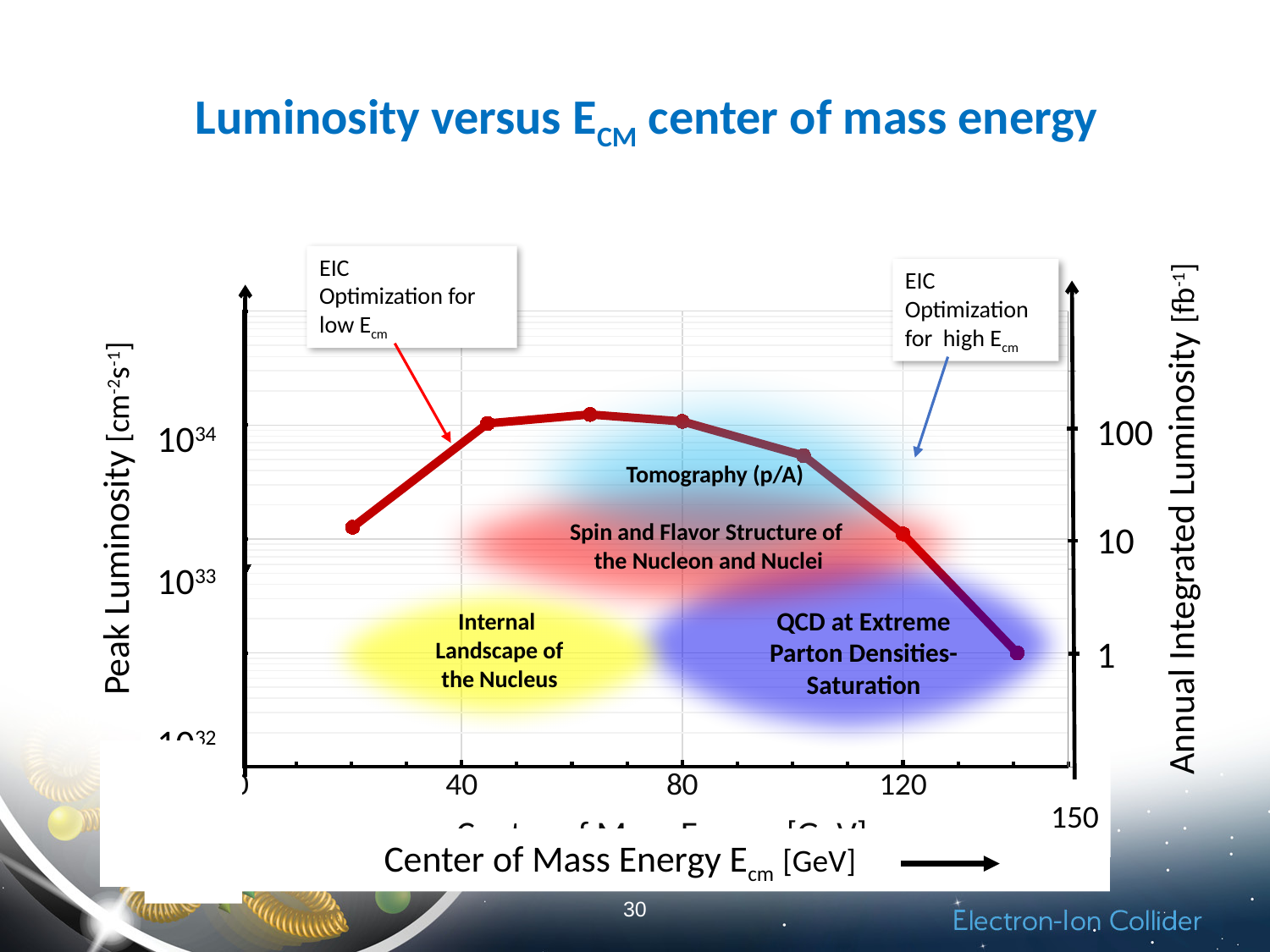
What is the title of the chart on the slide? Luminosity versus ECM center of mass energy Is the peak luminosity at about 100 GeV greater or less than 10^34 cm-2s-1? less How many data points are plotted on the luminosity curve? 7 At which end of the energy range is the peak luminosity lowest: the highest energy point (about 140 GeV) or the lowest energy point (about 20 GeV)? the highest energy point (about 140 GeV) Does the peak luminosity rise or fall as the center of mass energy increases from 20 GeV to 40 GeV? rise What kind of chart is shown on the slide? line chart Is the annual integrated luminosity at about 100 GeV greater or less than 10 fb-1? greater Is the peak luminosity at the lowest plotted center of mass energy (about 20 GeV) greater or less than 10^33 cm-2s-1? greater Does the peak luminosity rise or fall as the center of mass energy increases from 80 GeV to 150 GeV? fall What quantity is shown on the right-hand vertical axis? Annual Integrated Luminosity [fb-1] Which has the higher peak luminosity: the point at about 40 GeV or the point at about 120 GeV? the point at about 40 GeV